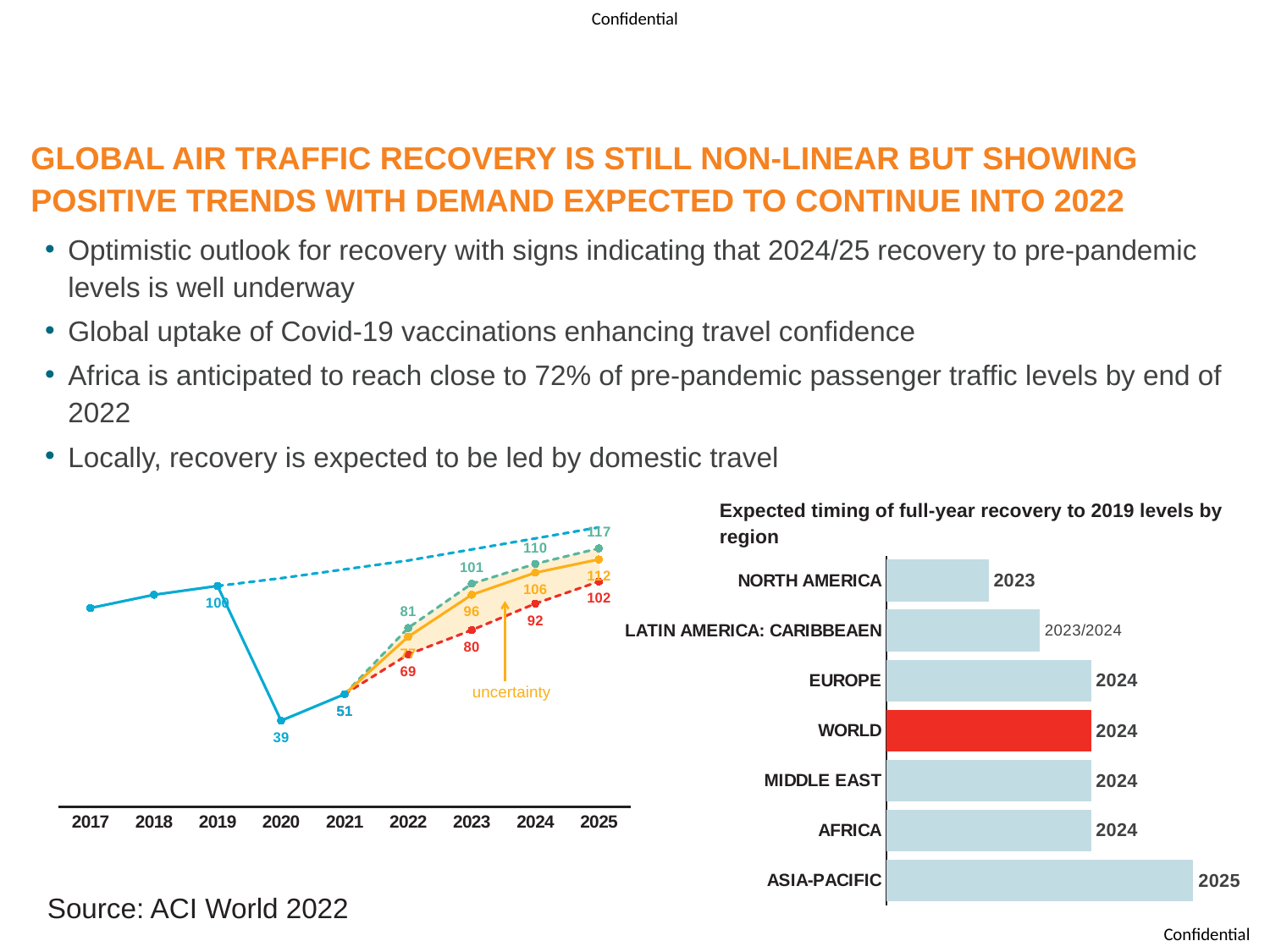
In the line chart on the left, what is the lowest value labelled for 2025? 102 In the line chart on the left, what is the difference between the 2019 value (100) and the 2020 value (39)? 61 In the chart 'Expected timing of full-year recovery to 2019 levels by region', which bar is coloured red? WORLD In the line chart on the left, how many years are shown on the x axis? 9 In the chart 'Expected timing of full-year recovery to 2019 levels by region', what is the expected recovery year for North America? 2023 In the line chart on the left, what value is labelled for 2020? 39 In the line chart on the left, what value is labelled for 2021? 51 In the line chart on the left, what is the highest value labelled for 2025? 117 In the line chart on the left, do the values rise or fall from 2021 to 2025? rise In the chart 'Expected timing of full-year recovery to 2019 levels by region', how many regions are listed? 7 In the chart 'Expected timing of full-year recovery to 2019 levels by region', what is the expected recovery year for Asia-Pacific? 2025 In the line chart on the left, which year has the lowest labelled value? 2020